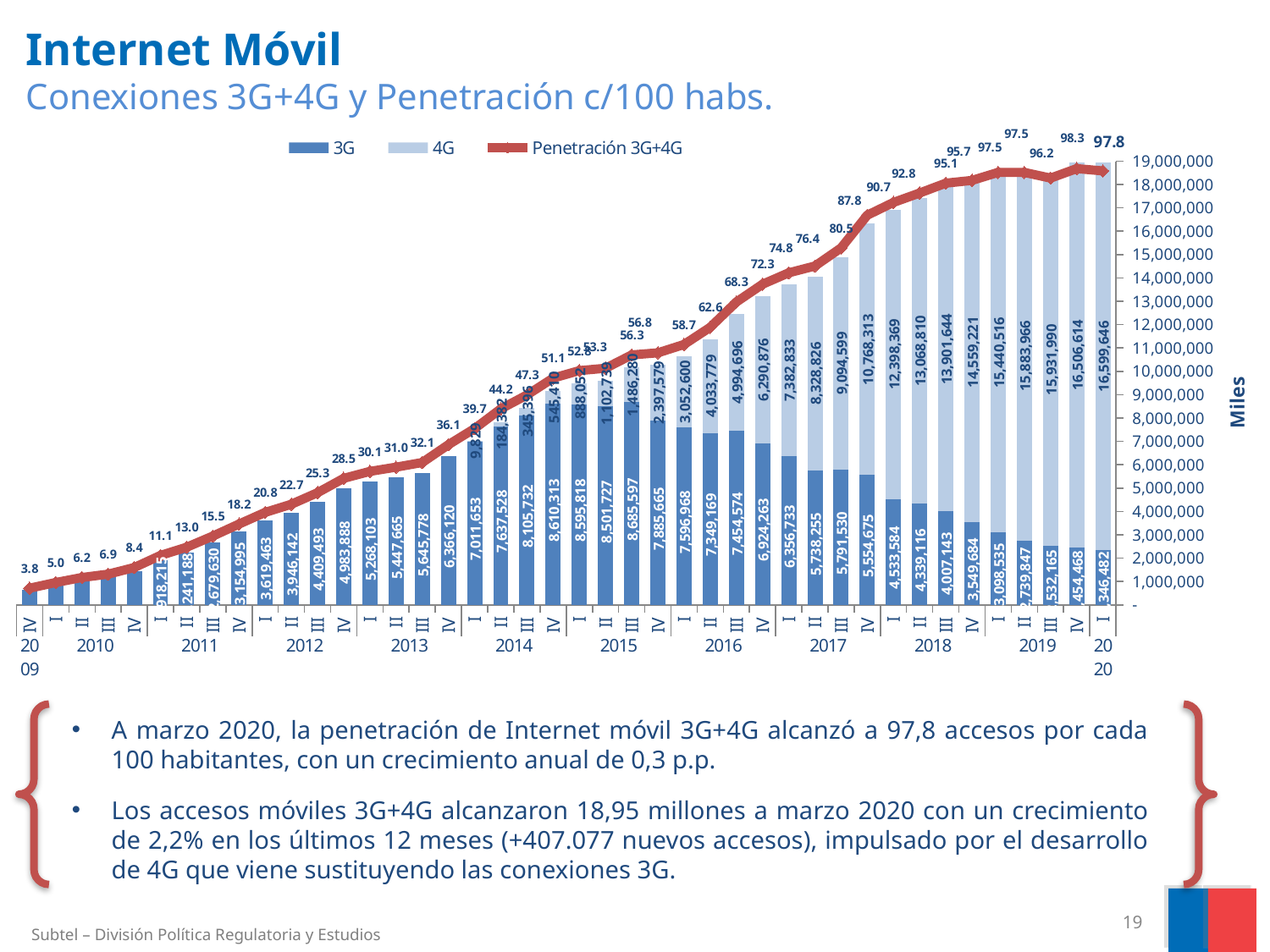
What is the lowest Penetración 3G+4G value shown on the line? 3.8 What is the total of the stacked bar (3G + 4G) for I 2020? 18,946,128 Does the Penetración 3G+4G line generally rise or fall from left to right? rise How many series does the chart legend list? 3 What is the 4G value for I 2020? 16,599,646 In I 2020, which is larger, the 3G value or the 4G value? 4G What is the highest 3G value labelled on the chart? 8,685,597 What is the highest Penetración 3G+4G value shown on the line? 98.3 What kind of chart is shown on the slide? bar chart with a line What is the Penetración 3G+4G value for the last point (I 2020)? 97.8 What is the difference between the Penetración 3G+4G values for IV 2019 (98.3) and I 2020 (97.8)? 0.5 What is the 3G value for I 2020? 2,346,482